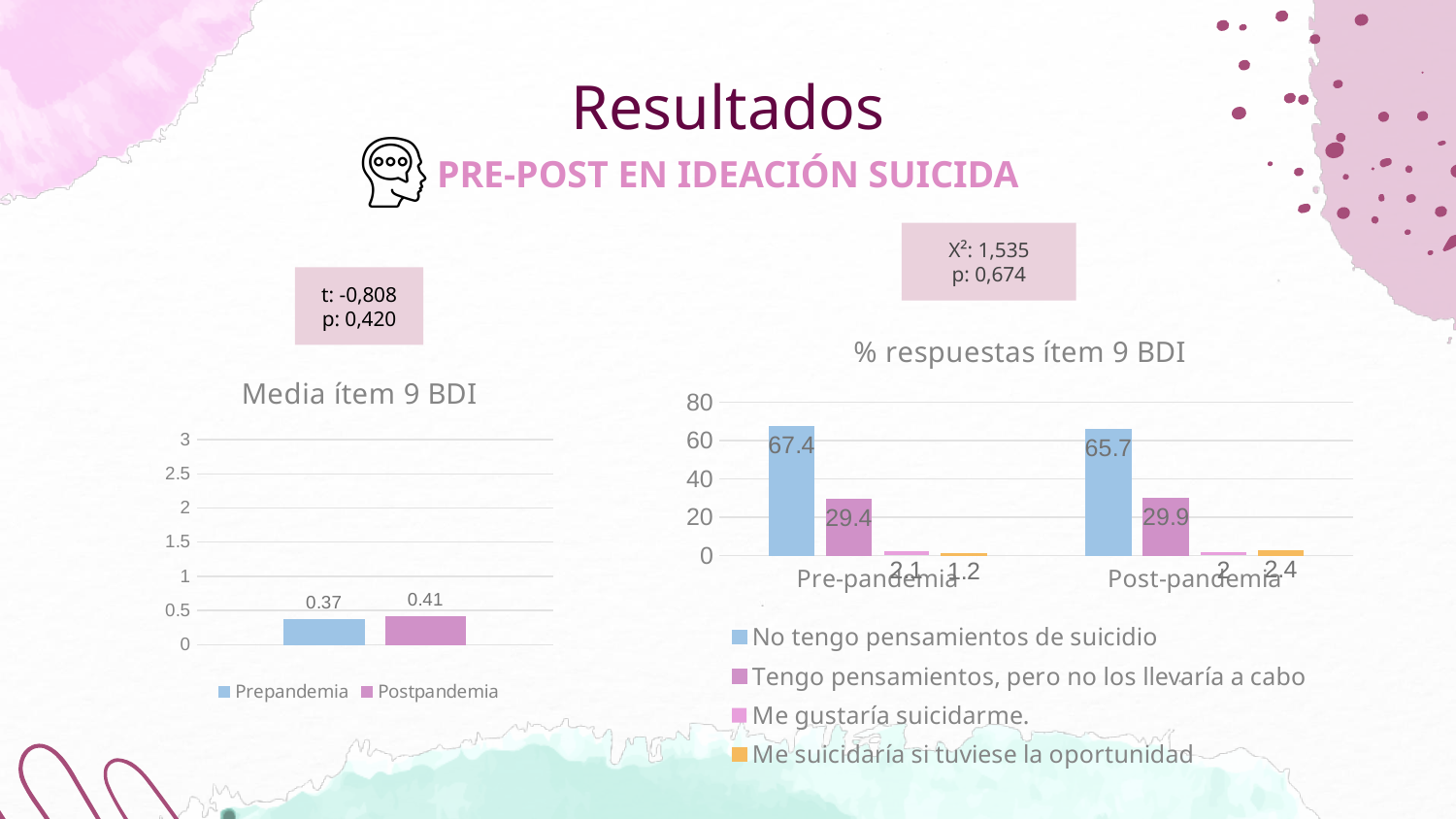
In the 'Media ítem 9 BDI' chart, how many series does the legend list? 2 In the '% respuestas ítem 9 BDI' chart, how many series does the legend list? 4 In the 'Media ítem 9 BDI' chart, what is the difference between the Postpandemia and Prepandemia values? 0.04 In the '% respuestas ítem 9 BDI' chart, what is the value for 'Tengo pensamientos, pero no los llevaría a cabo' in Post-pandemia? 29.9 In the 'Media ítem 9 BDI' chart, which is larger, Prepandemia or Postpandemia? Postpandemia In the 'Media ítem 9 BDI' chart, what is the value for Prepandemia? 0.37 In the '% respuestas ítem 9 BDI' chart, what is the difference between the 'No tengo pensamientos de suicidio' values for Pre-pandemia and Post-pandemia? 1.7 In the '% respuestas ítem 9 BDI' chart, which response has the highest value in Post-pandemia? No tengo pensamientos de suicidio In the '% respuestas ítem 9 BDI' chart, what is the value for 'No tengo pensamientos de suicidio' in Pre-pandemia? 67.4 In the 'Media ítem 9 BDI' chart, what is the value for Postpandemia? 0.41 What kind of chart is the '% respuestas ítem 9 BDI' chart? Bar chart In the '% respuestas ítem 9 BDI' chart, what is the value for 'Me suicidaría si tuviese la oportunidad' in Pre-pandemia? 1.2